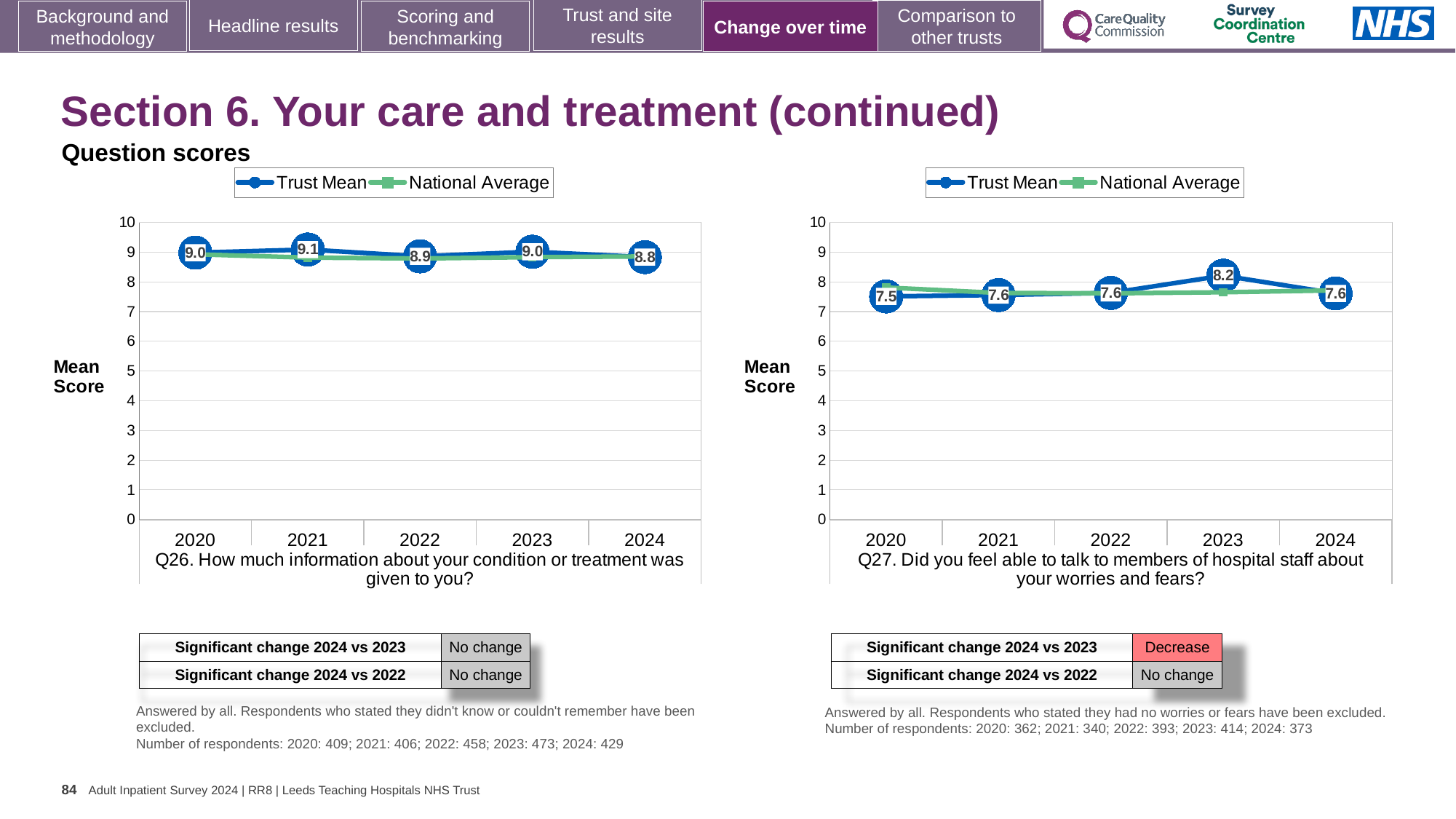
On the Q26 chart (left), is the Trust Mean score for 2021 larger or smaller than the score for 2022? larger On the Q27 chart (right), is the Trust Mean value for 2023 greater or less than 8? greater On the Q26 chart (left), which year has the lowest Trust Mean score? 2024 What kind of chart is the Q26 chart (left)? Line chart On the Q26 chart (left), what is the Trust Mean score for 2021? 9.1 On the Q26 chart (left), what is the Trust Mean score for 2024? 8.8 On the Q27 chart (right), what is the Trust Mean score for 2023? 8.2 On the Q27 chart (right), what is the Trust Mean score for 2020? 7.5 On the Q27 chart (right), what is the difference between the Trust Mean scores for 2023 and 2024? 0.6 How many series does the legend of the Q27 chart (right) list? 2 How many years are plotted on the x axis of the Q26 chart (left)? 5 On the Q27 chart (right), which year has the highest Trust Mean score? 2023